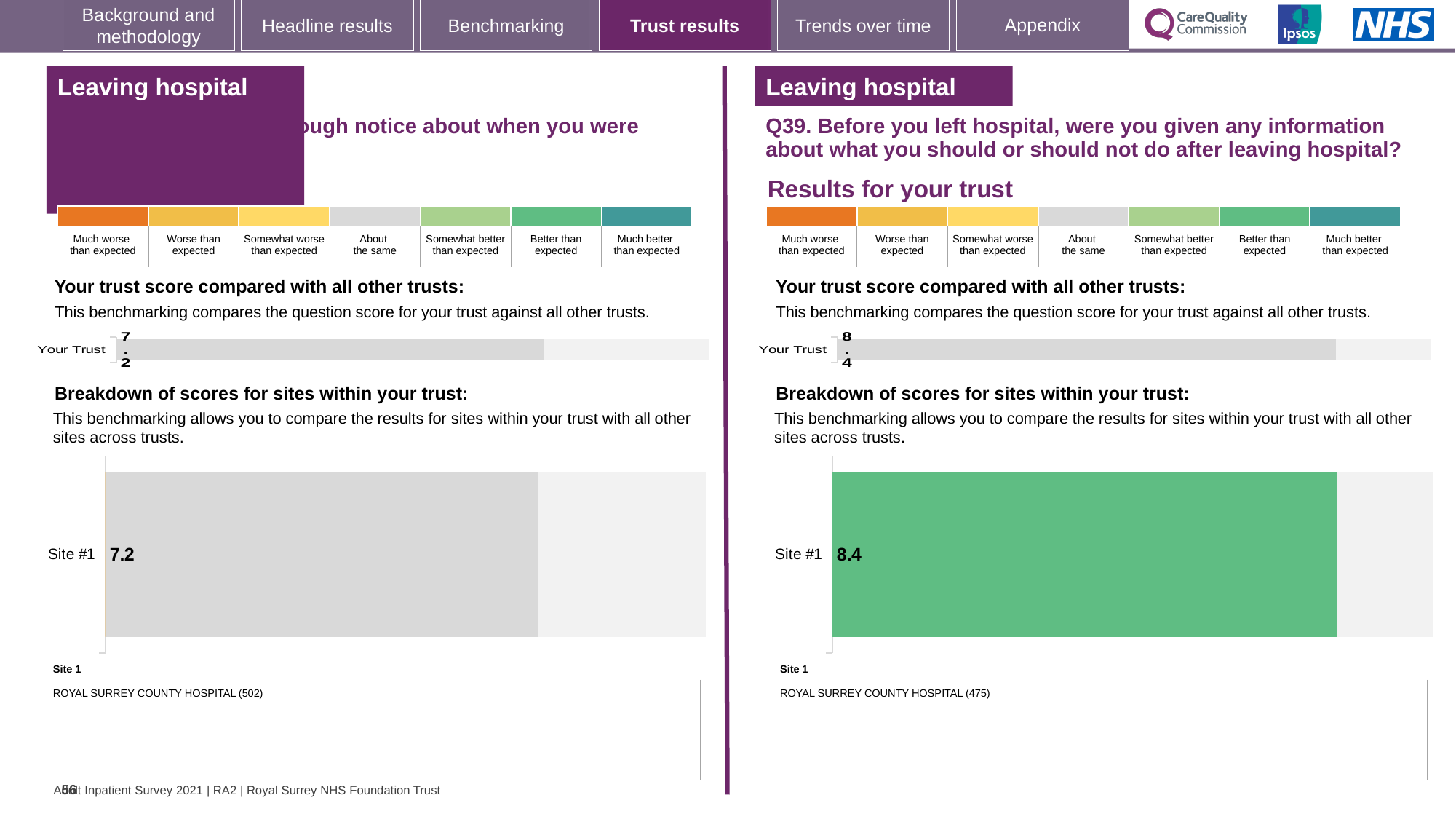
What is the difference between the Site #1 score in the right-hand breakdown chart and the Site #1 score in the left-hand breakdown chart? 1.2 What colour is the Site #1 bar in the right-hand breakdown chart? Green Which Site #1 score is larger: the one in the left-hand breakdown chart or the one in the right-hand breakdown chart? The right-hand chart (8.4) Is the Your Trust score in the right-hand (Q39) chart greater or less than the Your Trust score in the left-hand chart? greater In the left-hand 'Breakdown of scores for sites within your trust' chart, what is the score for Site #1? 7.2 What type of chart is used to show the Site #1 score in the right-hand 'Breakdown of scores for sites within your trust' section? Bar chart How many sites are plotted in the left-hand 'Breakdown of scores for sites within your trust' chart? 1 In the right-hand 'Breakdown of scores for sites within your trust' chart, what is the score for Site #1? 8.4 On the right-hand side (Q39), what is the score shown for Your Trust in the 'Your trust score compared with all other trusts' chart? 8.4 Which site name is listed under 'Site 1' for the right-hand (Q39) breakdown chart? ROYAL SURREY COUNTY HOSPITAL (475) On the left-hand side, what is the score shown for Your Trust in the 'Your trust score compared with all other trusts' chart? 7.2 How many sites are plotted in the right-hand 'Breakdown of scores for sites within your trust' chart? 1